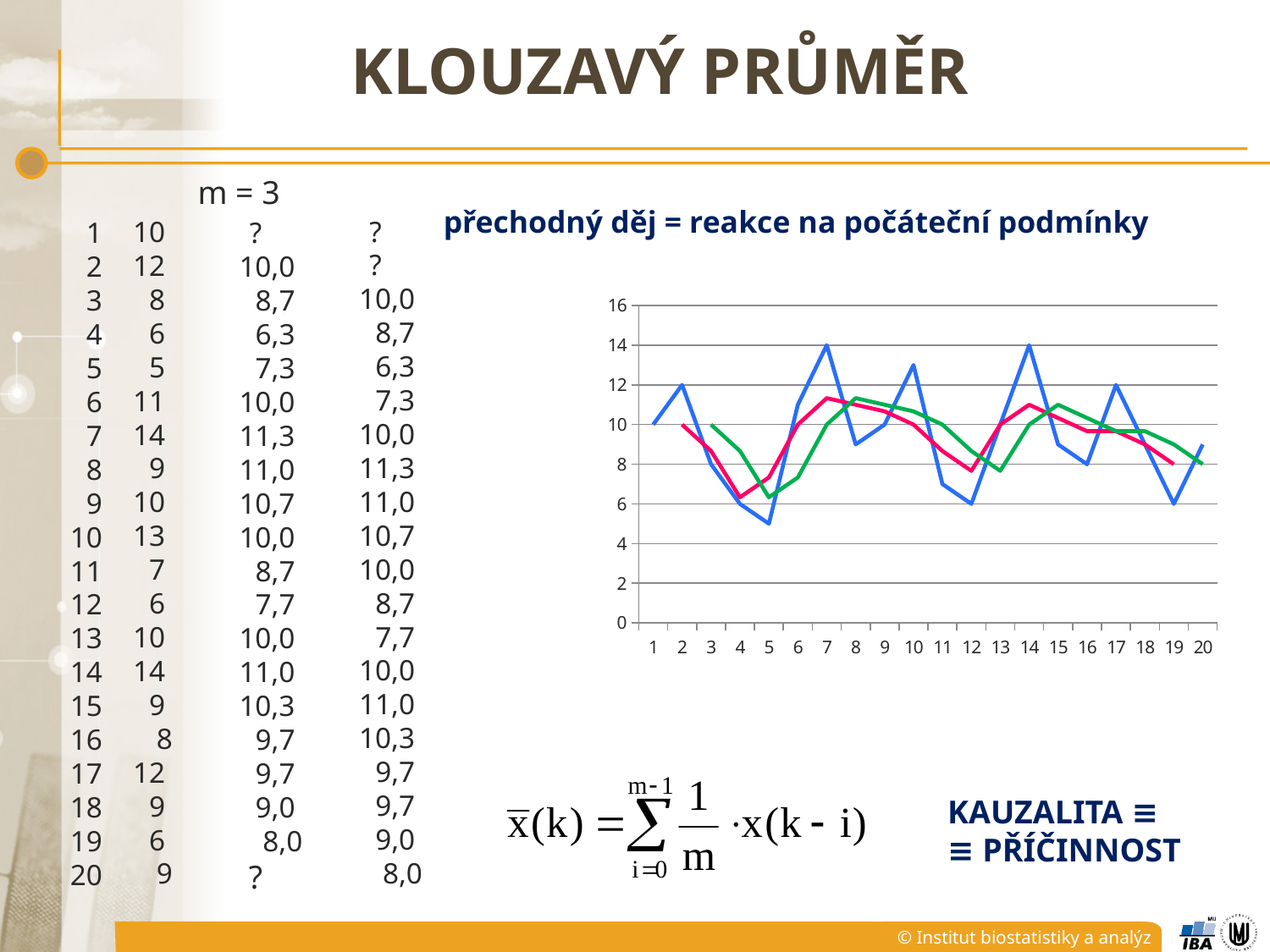
How many lines are plotted in the chart? 3 What kind of chart is shown on the slide? line chart Is the value of the red line at x = 7 greater or less than 10? greater What is the value of the blue line at x = 7? 14 Is the value of the green line at x = 5 greater or less than 8? less How many points are labelled along the x axis of the chart? 20 At which x value does the blue line reach its lowest point? 5 What is the value of the blue line at x = 2? 12 Does the blue line rise or fall between x = 1 and x = 5? fall What is the difference between the blue line's value at x = 7 and its value at x = 5? 9 Which is larger for the blue line: the value at x = 2 or the value at x = 3? x = 2 Is the value of the blue line at x = 5 greater or less than 6? less